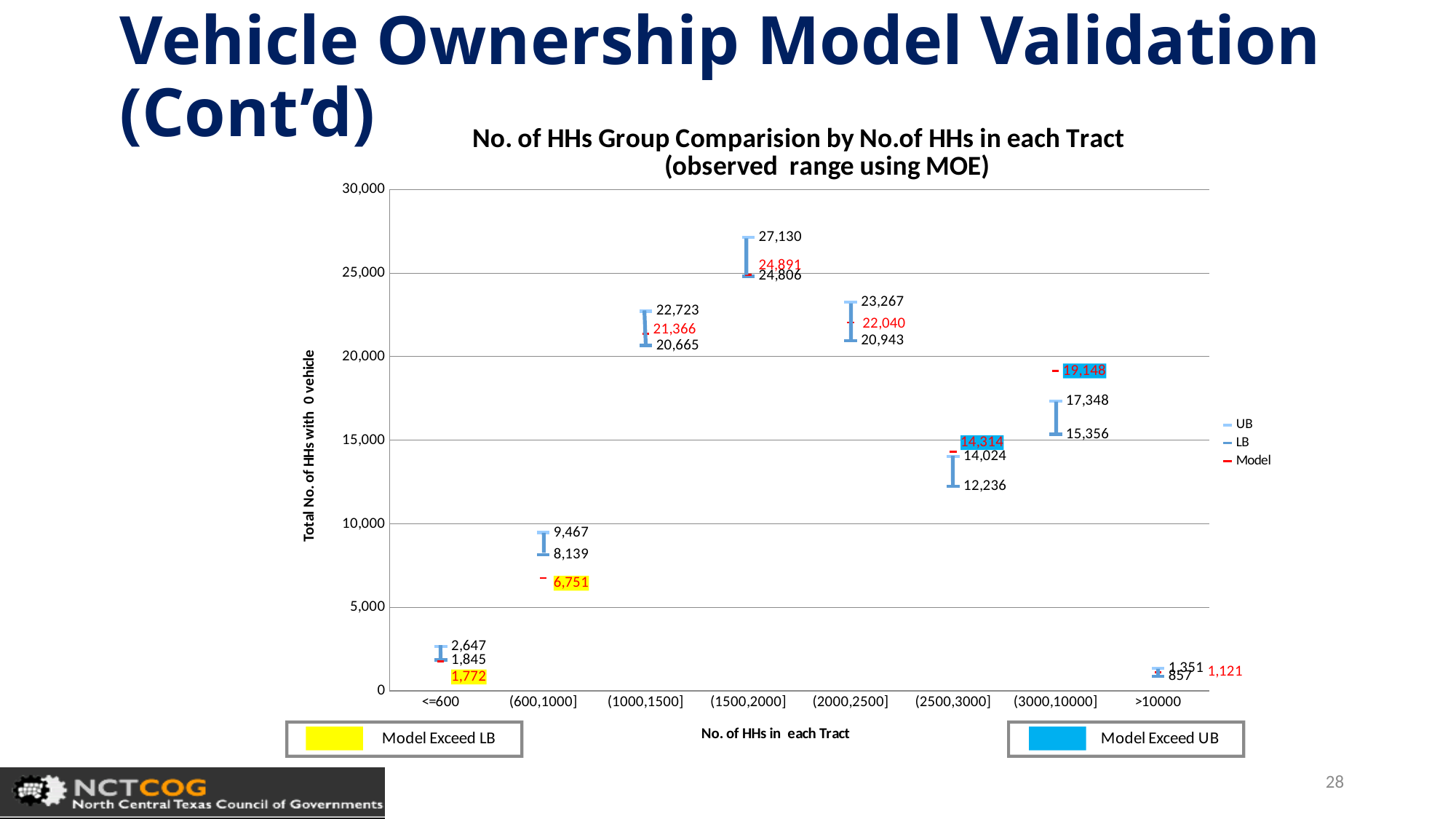
Which category has the highest UB value? (1500,2000] What is the LB value for the (2500,3000] category? 12,236 What is the UB value for the (1500,2000] category? 27,130 What is the Model value for the (600,1000] category? 6,751 Is the Model value for the (2000,2500] category greater or less than 20,000? greater What is the Model value for the (3000,10000] category? 19,148 Which category has the lowest LB value? >10000 What is the difference between the UB and LB values for the (1000,1500] category? 2,058 How many categories are shown on the x axis? 8 How many series does the legend list? 3 What does the yellow highlight on a Model value indicate, according to the key below the chart? Model Exceed LB Which is larger for the (2500,3000] category, the Model value or the UB value? Model value